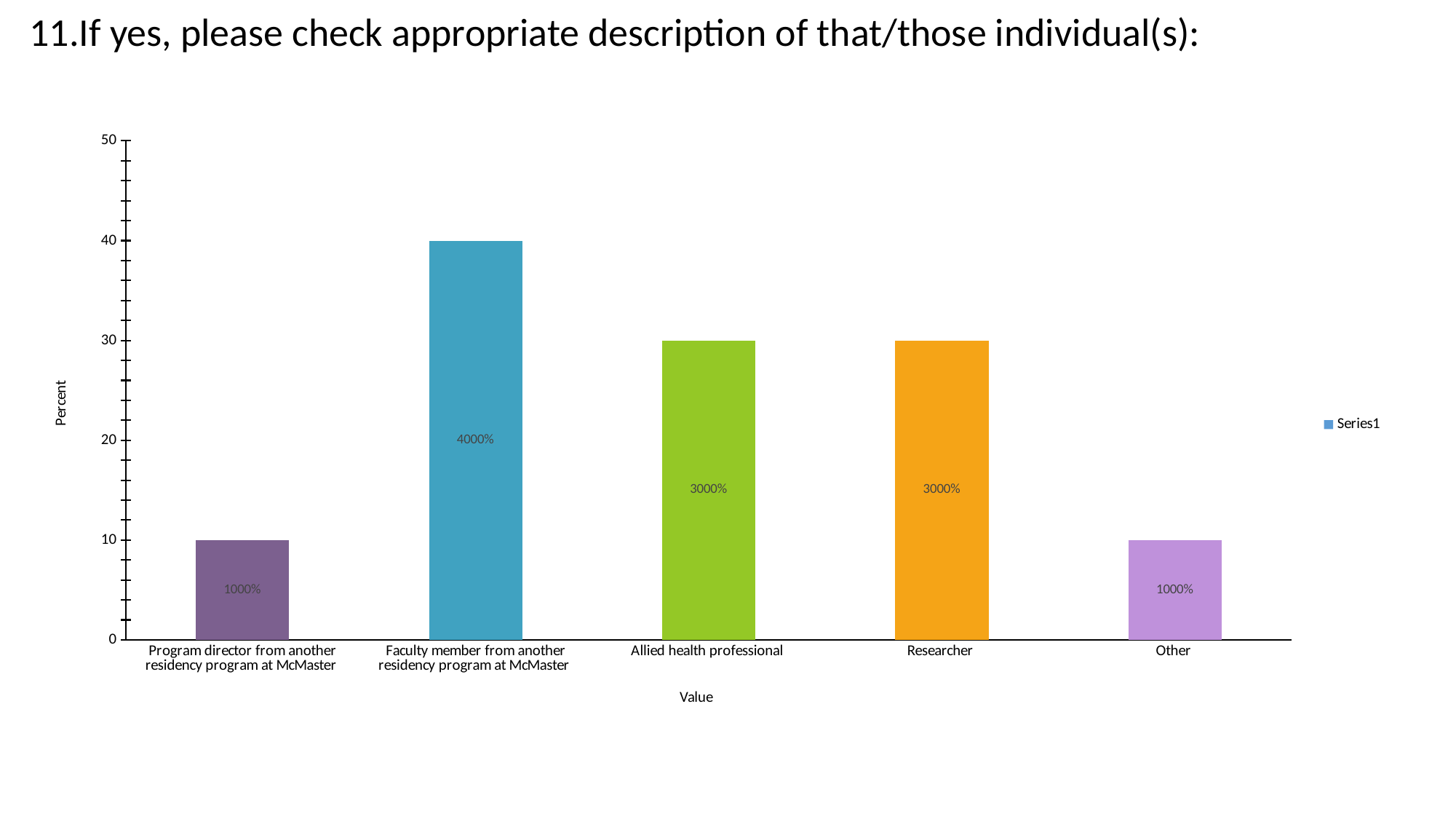
What is the data label shown on the bar for Other? 1000% What is the data label shown on the bar for Faculty member from another residency program at McMaster? 4000% Is the bar for Faculty member from another residency program at McMaster greater or less than 30 on the y axis? greater Which category has the highest bar? Faculty member from another residency program at McMaster What kind of chart is shown on the slide? Bar chart How many categories are shown on the x axis? 5 What is the difference between the data labels for Faculty member from another residency program at McMaster and Allied health professional? 1000% Which is larger, the value for Researcher or the value for Other? Researcher What is the data label shown on the bar for Allied health professional? 3000% What is the data label shown on the bar for Researcher? 3000% How many series does the legend list? 1 Is the bar for Program director from another residency program at McMaster greater or less than 20 on the y axis? less